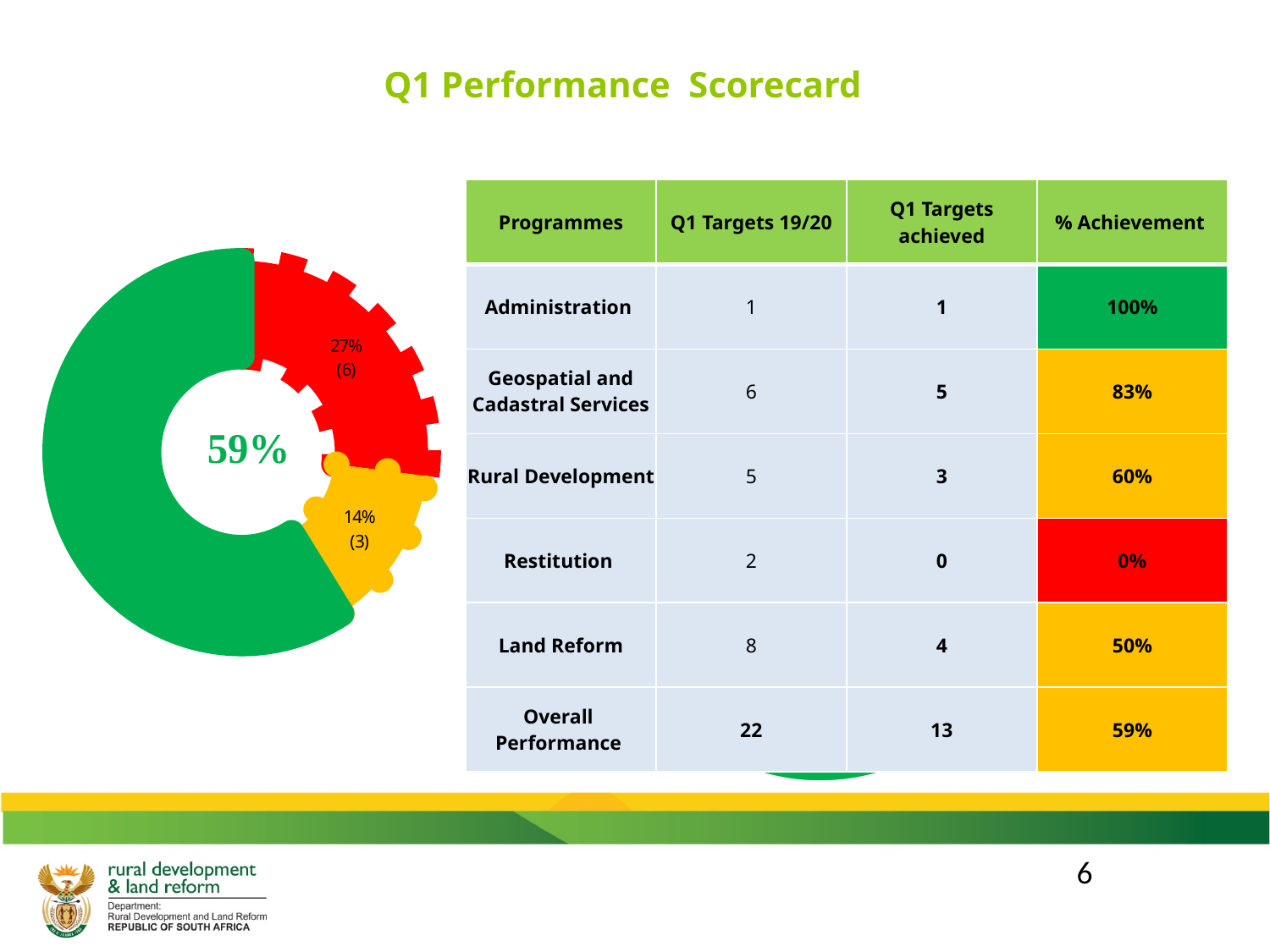
Which colour slice is the largest in the doughnut chart? Green What count is shown in brackets under the 14% label on the yellow slice? 3 Which colour slice is the smallest in the doughnut chart? Yellow What is the title of the slide containing the doughnut chart? Q1 Performance Scorecard What percentage is labelled on the red slice of the doughnut chart? 27% What percentage is shown in the centre of the doughnut chart? 59% What percentage is labelled on the yellow slice of the doughnut chart? 14% What count is shown in brackets under the 27% label on the red slice? 6 What is the difference in percentage points between the red slice (27%) and the yellow slice (14%)? 13 How many slices does the doughnut chart have? 3 Which slice is larger, the red slice or the yellow slice? Red What kind of chart is shown on the left of the slide? Doughnut chart